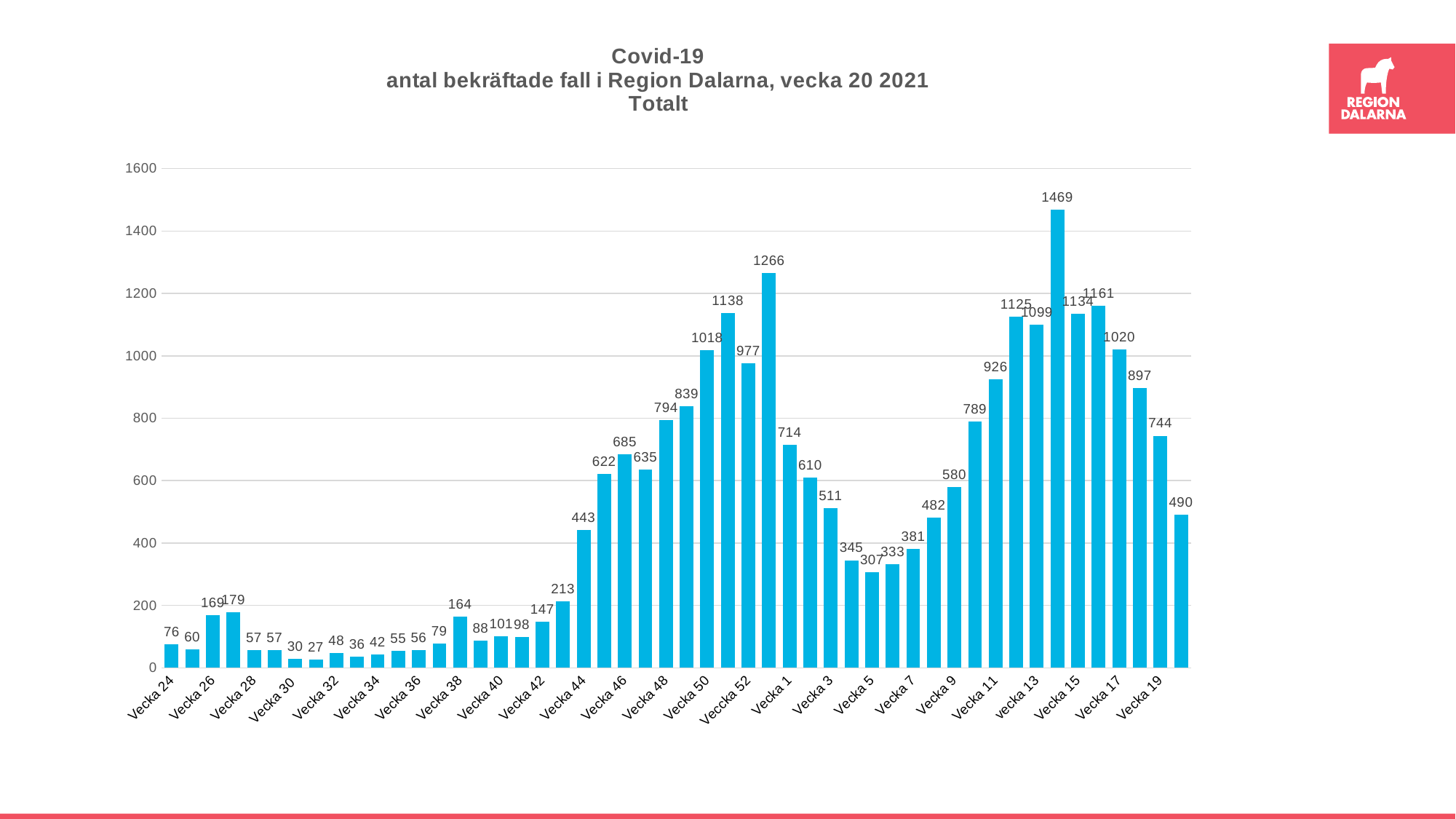
What is the value for Vecka 30? 30 Is the value for Vecka 9 greater or less than 600? less What is the value for Vecka 44? 443 What is the first line of the chart title? Covid-19 What kind of chart is shown on the slide? bar chart What is the difference between the values for Vecka 46 and Vecka 44? 242 Which has a larger value, Vecka 15 or Vecka 17? Vecka 15 What is the highest value shown on the chart? 1469 What is the value for Vecka 11? 926 How many bars are plotted on the chart? 50 Do the values rise or fall from Vecka 1 to Vecka 5? fall What is the lowest value shown on the chart? 27